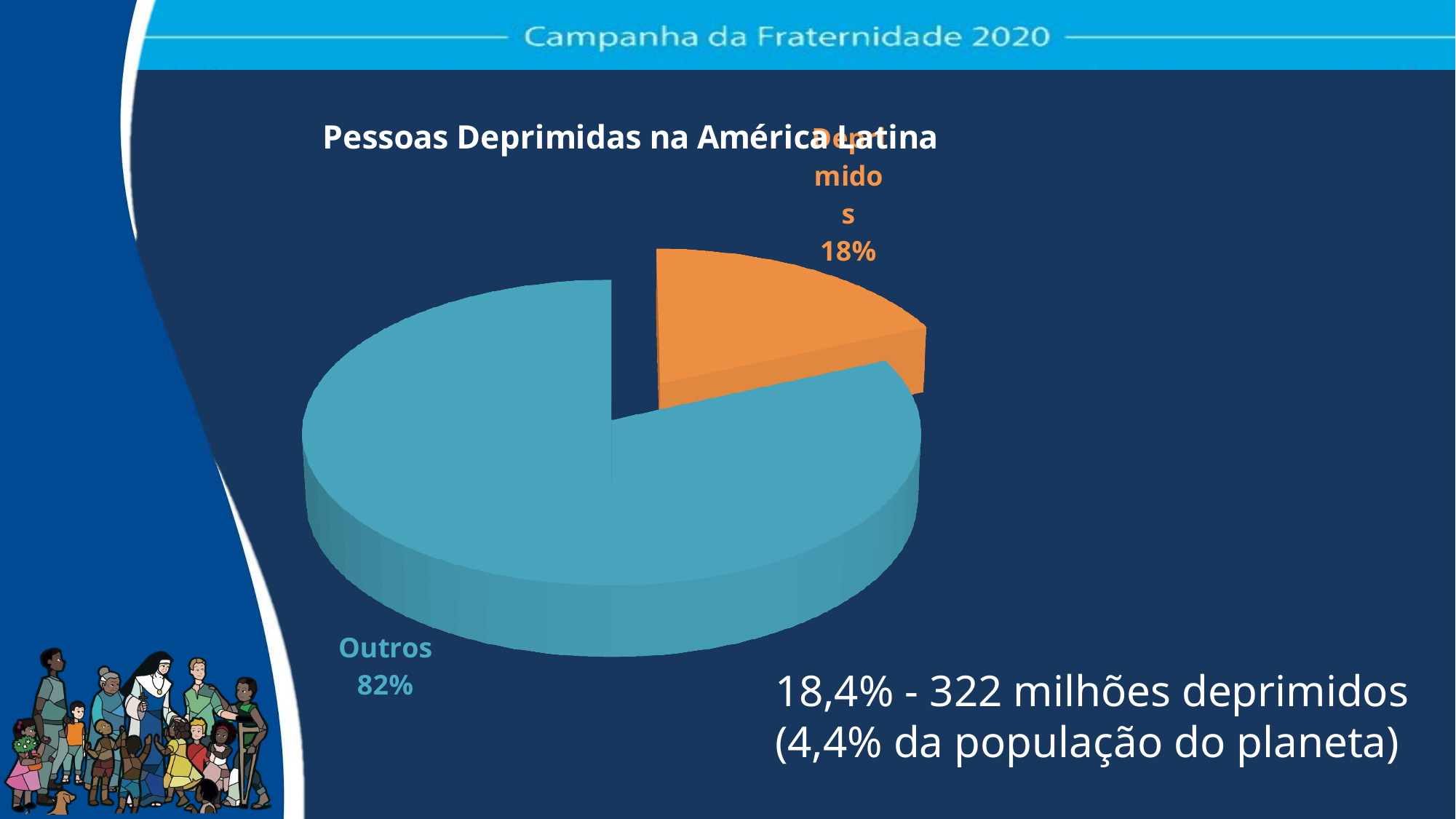
Which is larger, the "Deprimidos" slice or the "Outros" slice? Outros What share of the pie does the "Deprimidos" slice represent? 18% What kind of chart is shown on the slide? pie chart What percentage of the pie is labelled "Outros"? 82% Which slice of the pie is the smallest? Deprimidos How many slices does the pie chart have? 2 What percentage of the pie is labelled "Deprimidos"? 18% What is the difference in percentage points between the "Outros" slice and the "Deprimidos" slice? 64 What is the title of the chart? Pessoas Deprimidas na América Latina Which slice of the pie is the largest? Outros What colour is the "Deprimidos" slice? orange